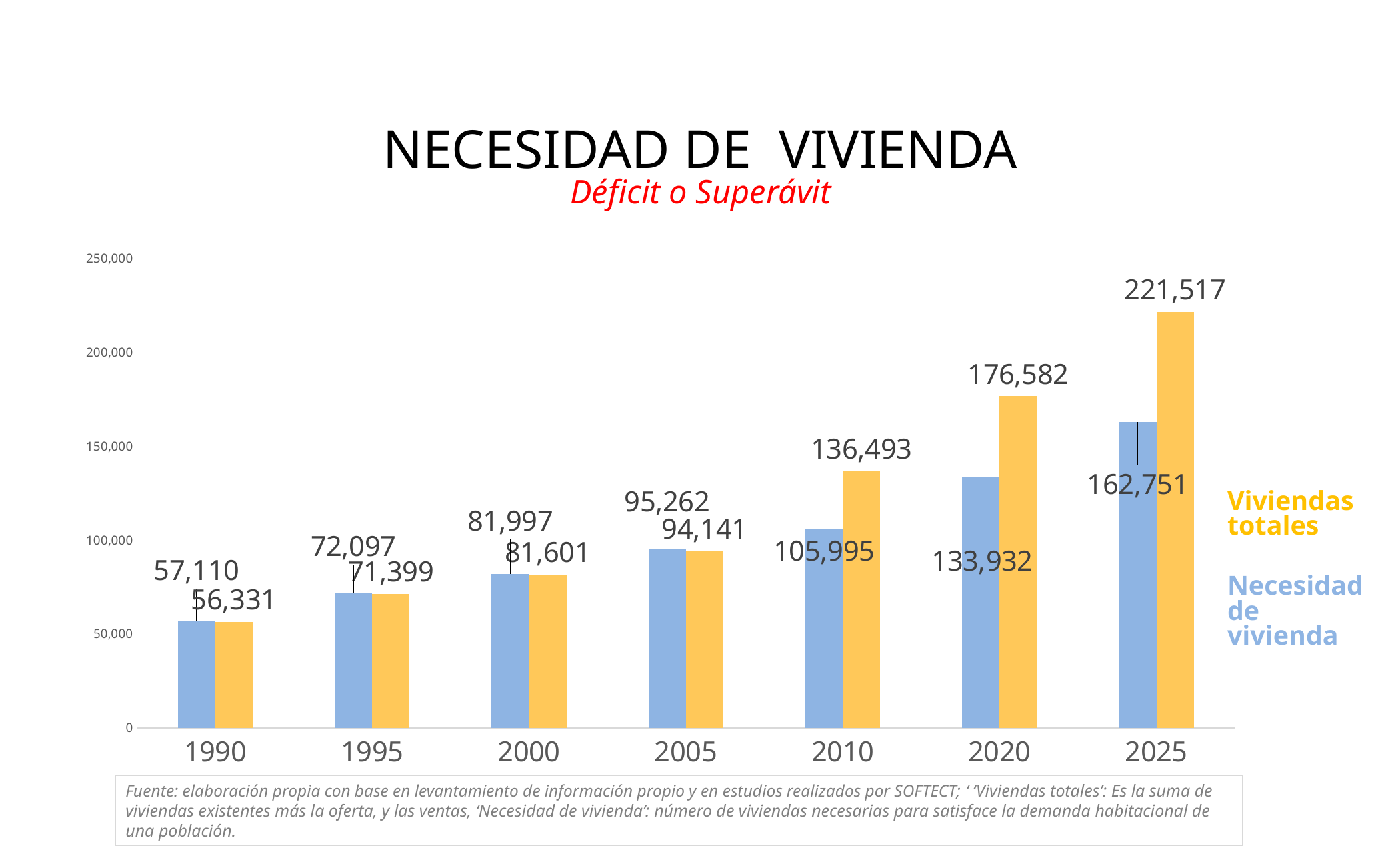
What is the difference between Viviendas totales and Necesidad de vivienda in 2010? 30,498 How many series does the chart show? 2 What is the value of Viviendas totales in 2020? 176,582 What is the difference between Viviendas totales and Necesidad de vivienda in 2025? 58,766 What type of chart is shown on the slide? Bar chart In 2020, which is larger: Viviendas totales or Necesidad de vivienda? Viviendas totales What is the value of Necesidad de vivienda in 2005? 95,262 In which year is Necesidad de vivienda lowest? 1990 What is the value of Necesidad de vivienda in 2025? 162,751 How many years are shown on the x axis? 7 What is the value of Viviendas totales in 1990? 56,331 In which year is Viviendas totales highest? 2025